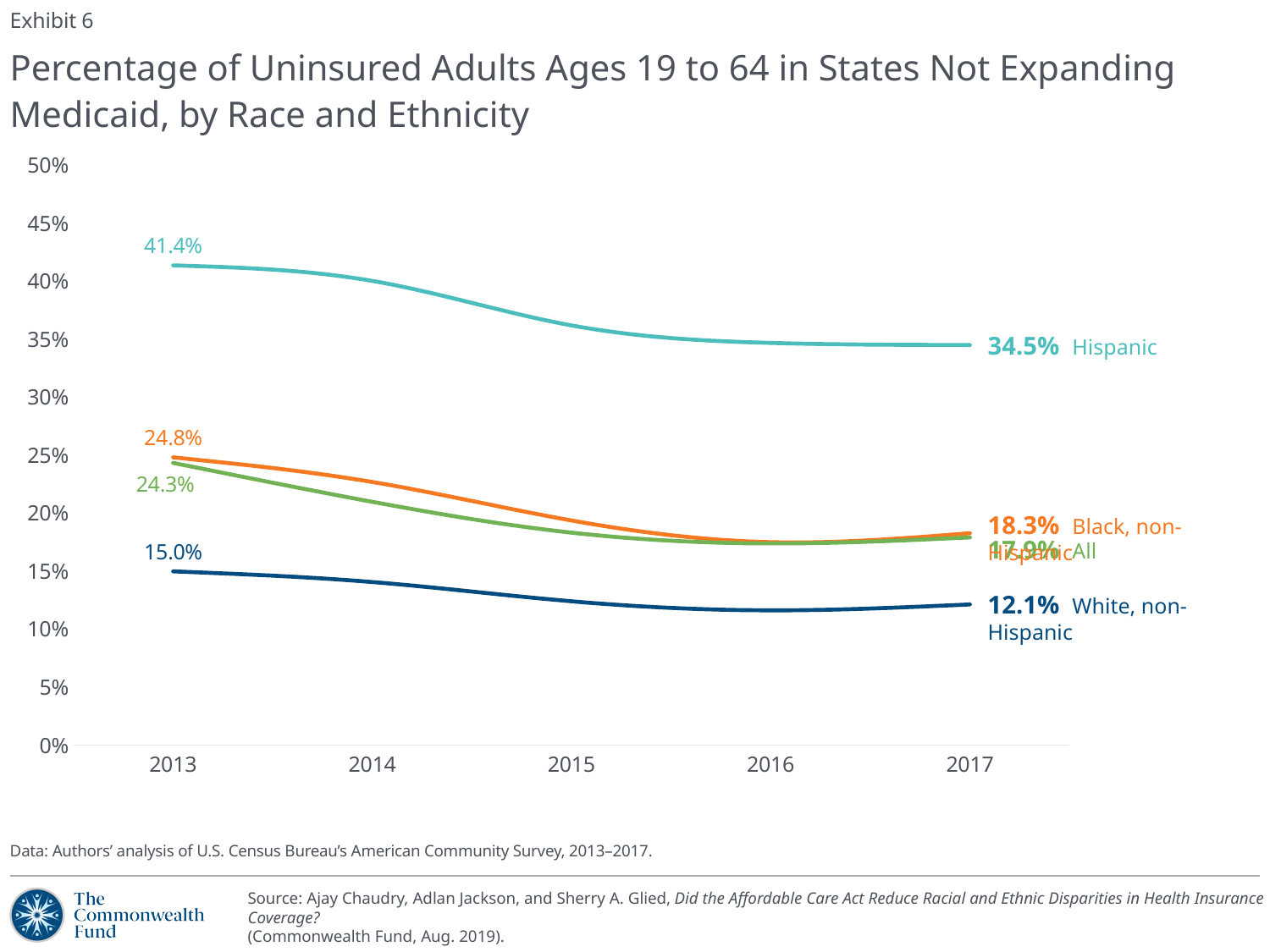
Does the uninsured rate for Hispanic adults rise or fall from 2013 to 2017? fall What was the percentage of uninsured Hispanic adults in 2017? 34.5% By how many percentage points did the uninsured rate for White, non-Hispanic adults fall from 2013 to 2017? 2.9 percentage points By how many percentage points did the uninsured rate for Hispanic adults fall from 2013 to 2017? 6.9 percentage points What was the percentage of uninsured White, non-Hispanic adults in 2017? 12.1% What was the percentage of uninsured Hispanic adults in 2013? 41.4% Is the uninsured rate for Hispanic adults in 2015 greater or less than 30%? greater What was the percentage of uninsured White, non-Hispanic adults in 2013? 15.0% Which group had the lowest uninsured rate in 2013? White, non-Hispanic What was the percentage of uninsured Black, non-Hispanic adults in 2013? 24.8% What kind of chart is shown on the slide? line chart Which group had the highest uninsured rate in 2017? Hispanic